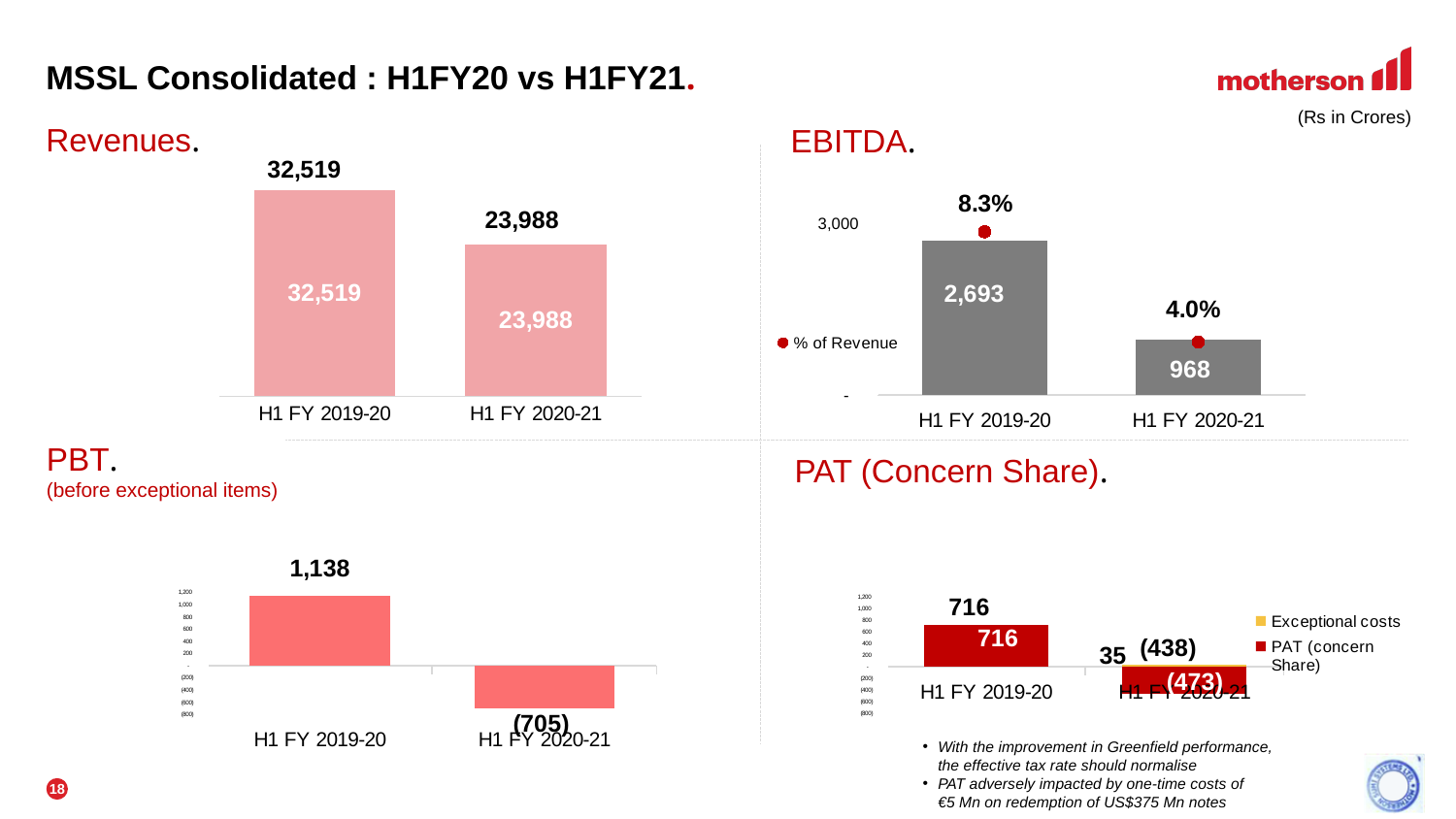
On the EBITDA chart, what is the EBITDA value for H1 FY 2019-20? 2,693 What kind of chart is the Revenues chart? Bar chart On the PBT chart, what is the value for H1 FY 2020-21? (705) On the PAT (Concern Share) chart, how many series does the legend list? 2 On the PAT (Concern Share) chart, what is the value for H1 FY 2019-20? 716 On the EBITDA chart, what is the difference in EBITDA between H1 FY 2019-20 and H1 FY 2020-21? 1,725 On the Revenues chart, what is the value for H1 FY 2020-21? 23,988 On the EBITDA chart, which period has the higher % of Revenue? H1 FY 2019-20 On the Revenues chart, what is the difference between H1 FY 2019-20 and H1 FY 2020-21? 8,531 On the PBT chart, what is the value for H1 FY 2019-20? 1,138 On the Revenues chart, what is the value for H1 FY 2019-20? 32,519 On the EBITDA chart, what is the % of Revenue for H1 FY 2020-21? 4.0%